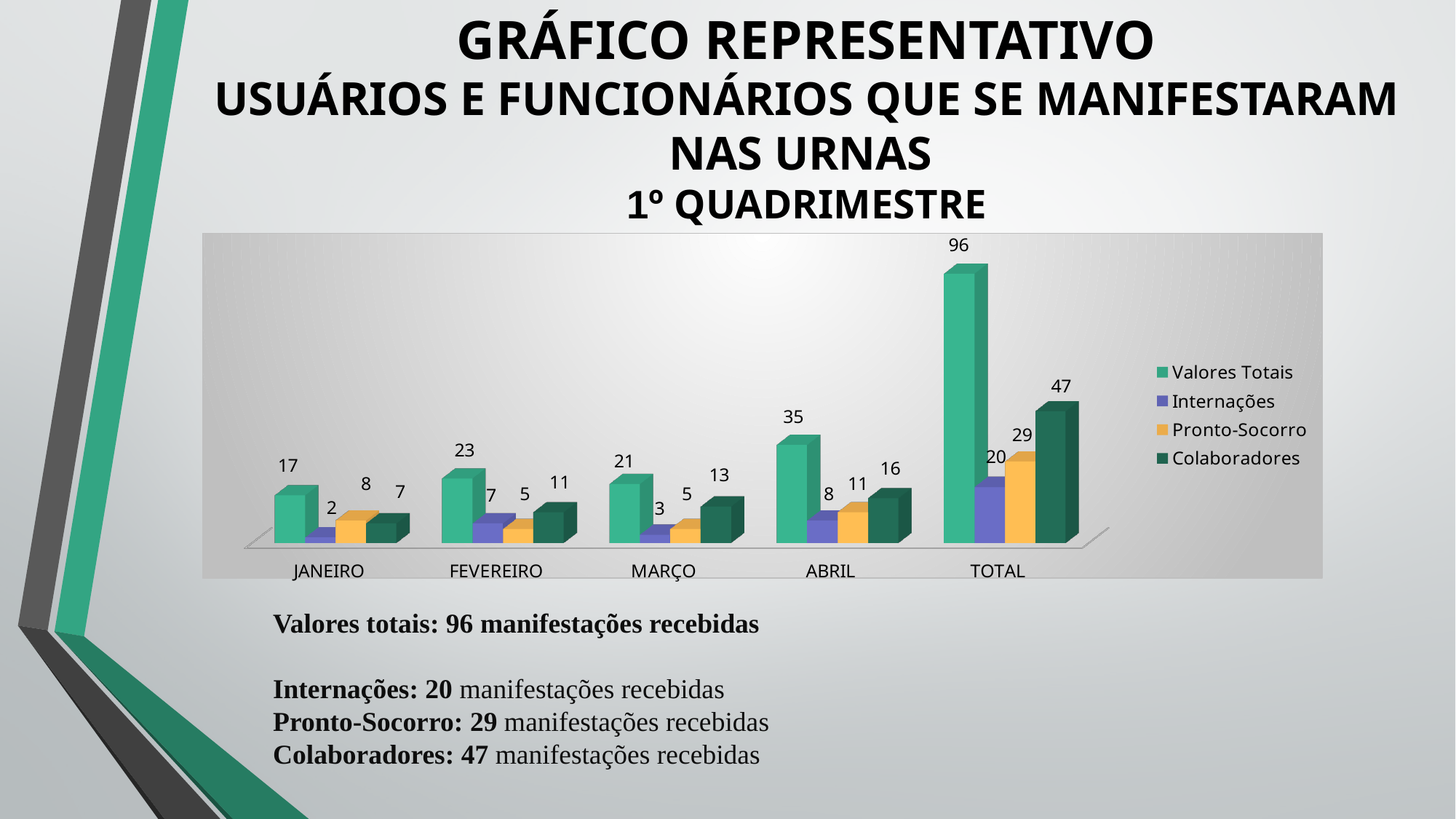
Which month has the lowest Internações value? JANEIRO Which category has the highest Valores Totais value? TOTAL Do the Valores Totais values rise or fall from JANEIRO to FEVEREIRO? Rise How many categories are shown on the x axis? 5 What is the value of Pronto-Socorro for MARÇO? 5 What is the value of Internações for FEVEREIRO? 7 What is the difference between the Valores Totais for ABRIL and for MARÇO? 14 How many series does the legend list? 4 What is the value of Valores Totais for JANEIRO? 17 What is the value of Colaboradores for ABRIL? 16 Which is larger: Pronto-Socorro for JANEIRO or Colaboradores for JANEIRO? Pronto-Socorro for JANEIRO What kind of chart is shown on the slide? Bar chart